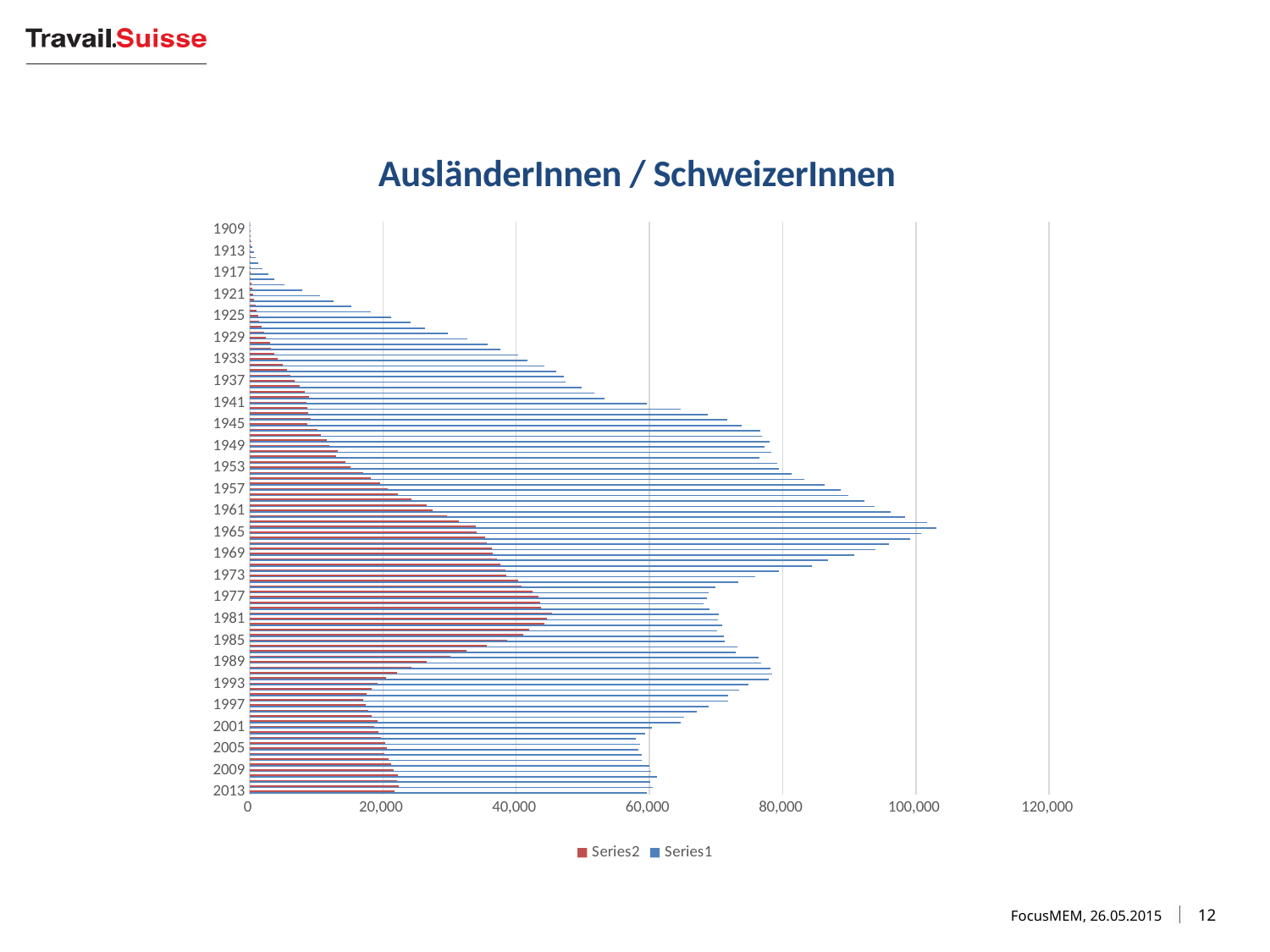
Is the Series1 value for 1913 greater or less than 20,000? less For 1965, which series has the larger value, Series1 or Series2? Series1 Is the Series2 value for 1981 greater or less than 40,000? greater Which year has the highest Series1 value? 1964 What are the two legend entries of the chart? Series2 and Series1 What kind of chart is shown on the slide? bar chart Is the Series2 value for 1949 greater or less than 20,000? less How many series does the legend list? 2 What is the title of the chart? AusländerInnen / SchweizerInnen